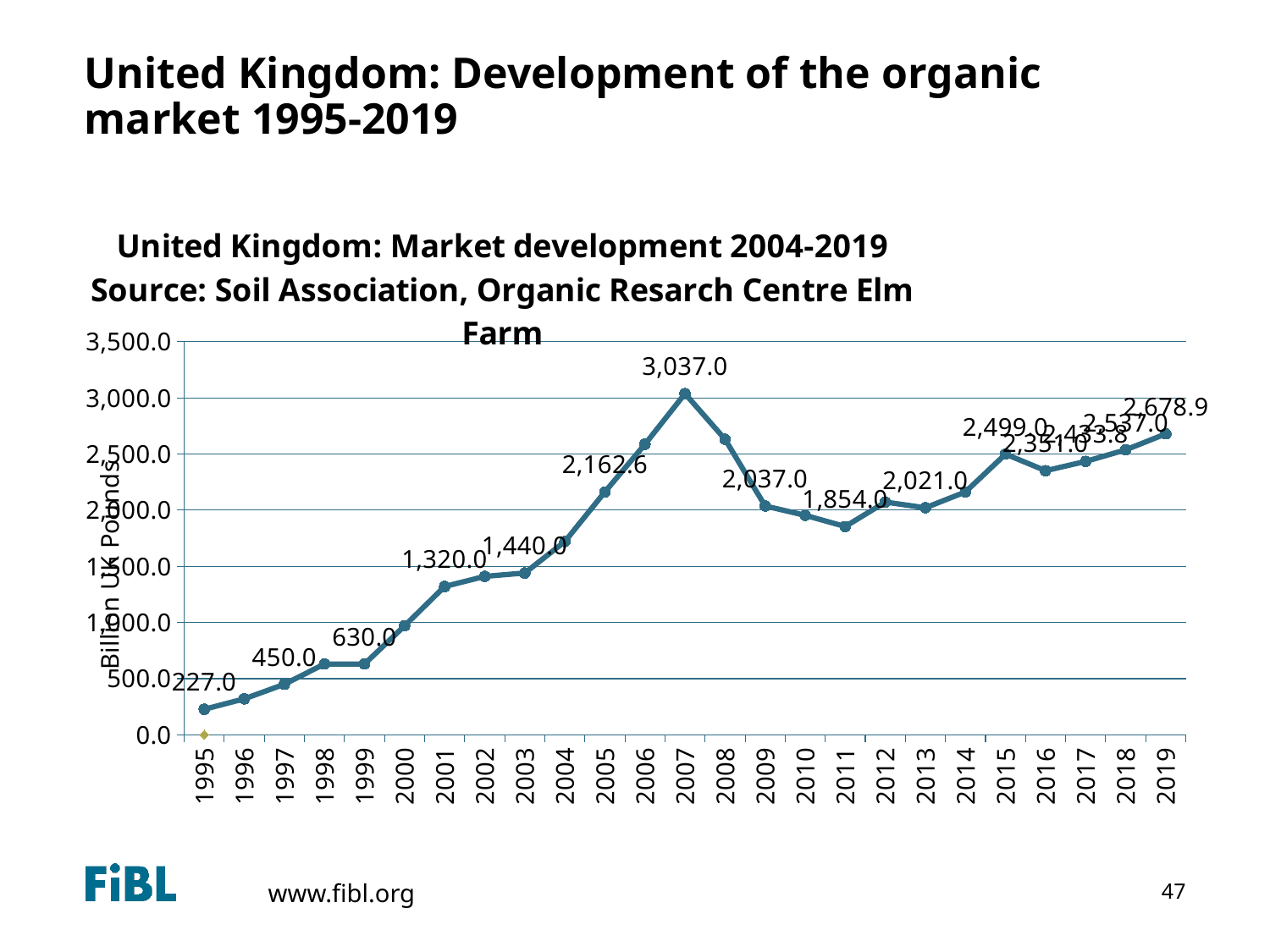
What is the value for 2007? 3,037.0 What kind of chart is shown on the slide? line chart How many years are plotted on the x axis? 25 What is the difference between the values for 2007 and 2009? 1,000.0 What is the value for 1995? 227.0 Which year has the lowest value? 1995 Which year has the highest value? 2007 What is the value for 2011? 1,854.0 Do the values rise or fall from 1995 to 2007? rise Is the value for 2004 greater or less than 1,500.0? greater What is the value for 2019? 2,678.9 Which is larger, the value for 2015 or the value for 2016? 2015